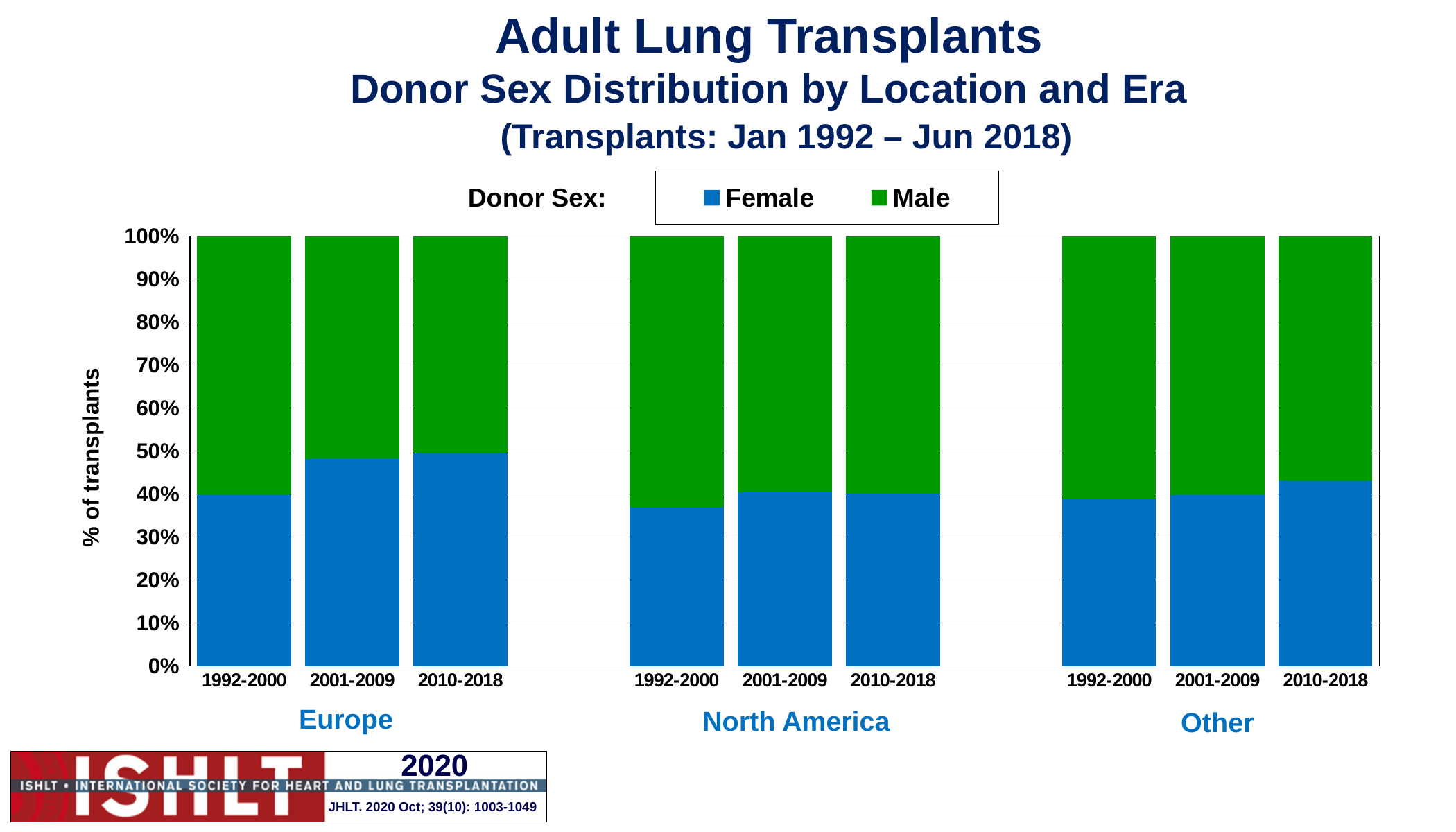
How many bars are plotted in the chart? 9 Which has the larger Female share: Europe 2001-2009 or North America 2001-2009? Europe 2001-2009 Is the Male share for Europe in 1992-2000 greater or less than 50%? greater Which colour represents Female donors in the chart? Blue Which era in North America has the lowest Female share? 1992-2000 What kind of chart is shown on the slide? Stacked bar chart Is the Female share for North America in 1992-2000 greater or less than 40%? less Does the Female share for Europe rise or fall across the eras from 1992-2000 to 2010-2018? Rises Which era in the Other region has the highest Female share? 2010-2018 How many series does the legend list? 2 What is the label on the vertical axis? % of transplants Is the Female share for Europe in 2001-2009 greater or less than 40%? greater